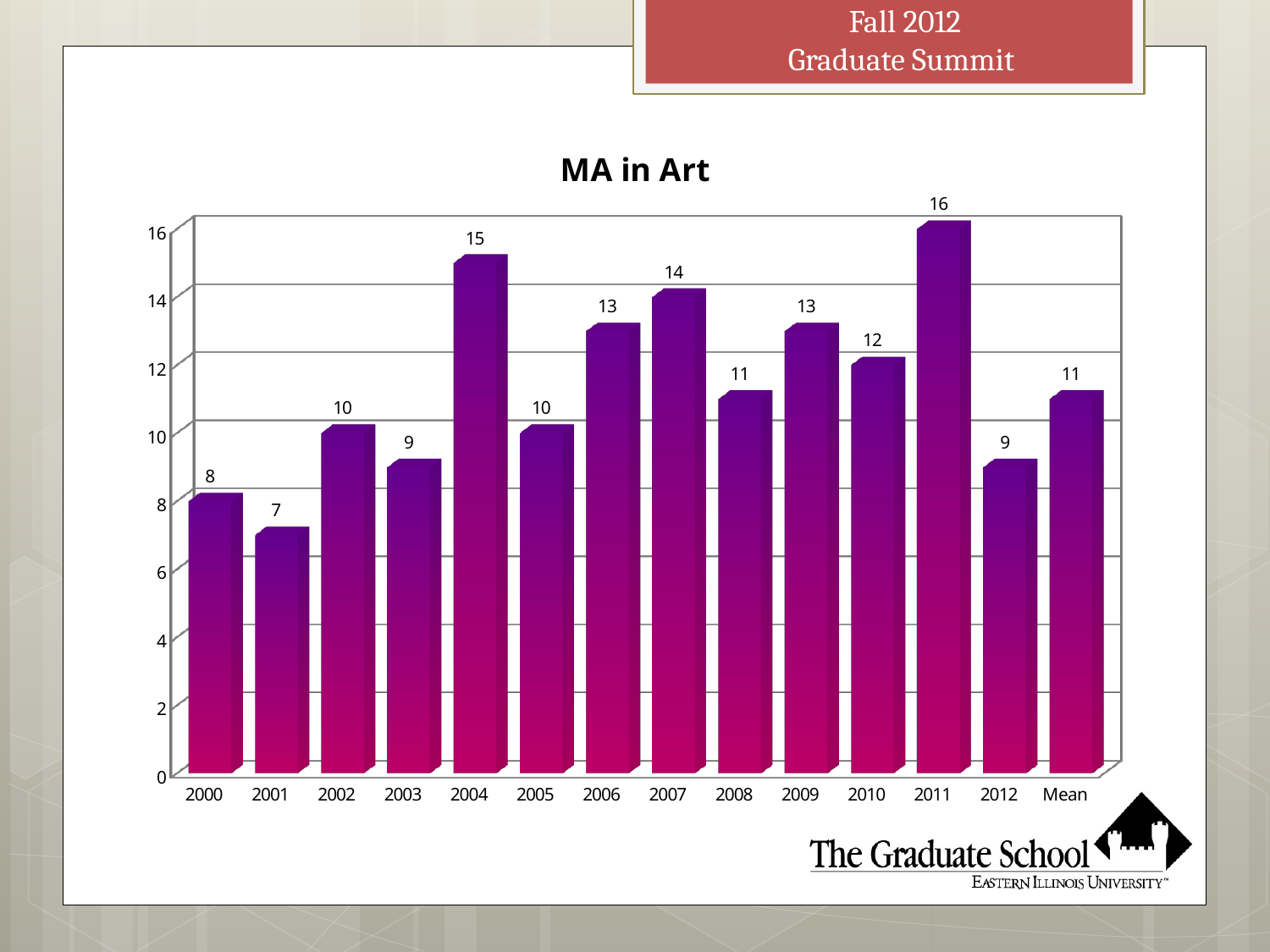
Which is larger, the value for 2007 or the value for 2009? 2007 What is the title of the chart? MA in Art What is the value for 2001? 7 What is the difference between the values for 2011 and 2012? 7 How many categories are shown on the x axis? 14 Which year has the lowest value? 2001 What is the difference between the values for 2000 and 2010? 4 Which year has the highest value? 2011 Do the values rise or fall from 2001 to 2004? rise What is the value for 2004? 15 What is the value shown for Mean? 11 What kind of chart is this? bar chart